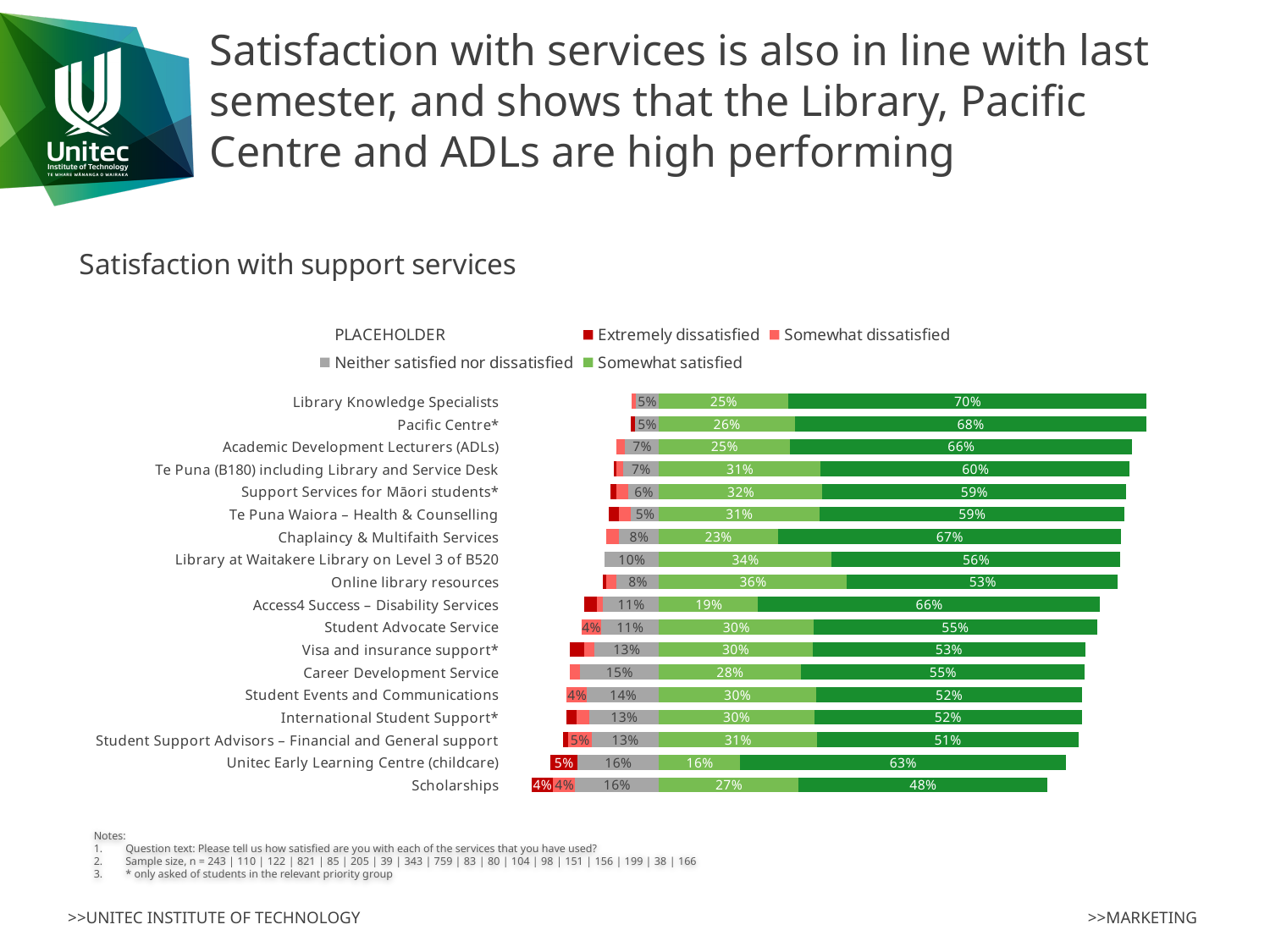
What is the 'Neither satisfied nor dissatisfied' value for Unitec Early Learning Centre (childcare)? 16% Which service has the highest value in the dark green (largest) segment? Library Knowledge Specialists What is the 'Neither satisfied nor dissatisfied' value for Career Development Service? 15% What is the value of the dark green (largest) segment for Library Knowledge Specialists? 70% Which service has the lowest value in the dark green (largest) segment? Scholarships What is the 'Somewhat satisfied' value for Library at Waitakere Library on Level 3 of B520? 34% Which has the larger 'Somewhat satisfied' value: Online library resources or Chaplaincy & Multifaith Services? Online library resources What kind of chart is shown on the slide? Stacked bar chart How many support services (categories) are listed in the chart? 18 What is the title of the chart? Satisfaction with support services What is the difference between the dark green segment values for Pacific Centre* and Scholarships? 20 percentage points What is the 'Somewhat satisfied' value for Online library resources? 36%